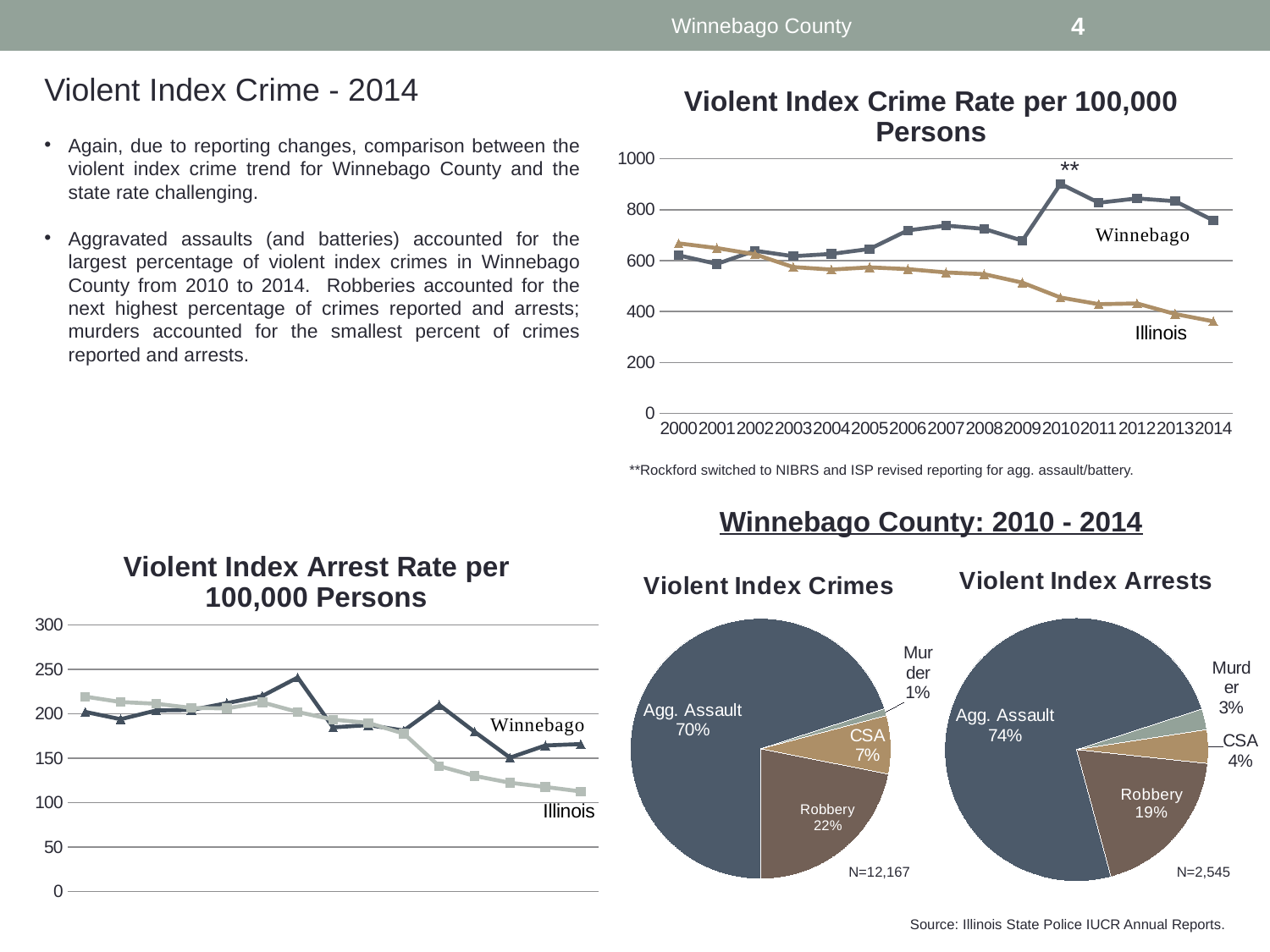
In the Violent Index Crimes pie chart, what share of crimes is Agg. Assault? 70% In the Violent Index Crimes pie chart, which category has the smallest slice? Murder In the Violent Index Arrests pie chart, which category has the largest slice? Agg. Assault In the Violent Index Crime Rate per 100,000 Persons chart, does the Illinois line generally rise or fall from 2000 to 2014? Fall What is the N value shown for the Violent Index Arrests pie chart? N=2,545 In the Violent Index Crime Rate per 100,000 Persons chart, is the Illinois value for 2014 greater or less than 400? less What kind of chart is the Violent Index Crime Rate per 100,000 Persons chart? Line chart How many series are plotted in the Violent Index Crime Rate per 100,000 Persons chart? 2 In the Violent Index Arrests pie chart, what share of arrests is Robbery? 19% How many percentage points higher is the Agg. Assault share in the Violent Index Arrests pie than in the Violent Index Crimes pie? 4 percentage points In the Violent Index Crime Rate per 100,000 Persons chart, is the Winnebago value for 2010 greater or less than 800? greater How many slices does the Violent Index Crimes pie chart have? 4